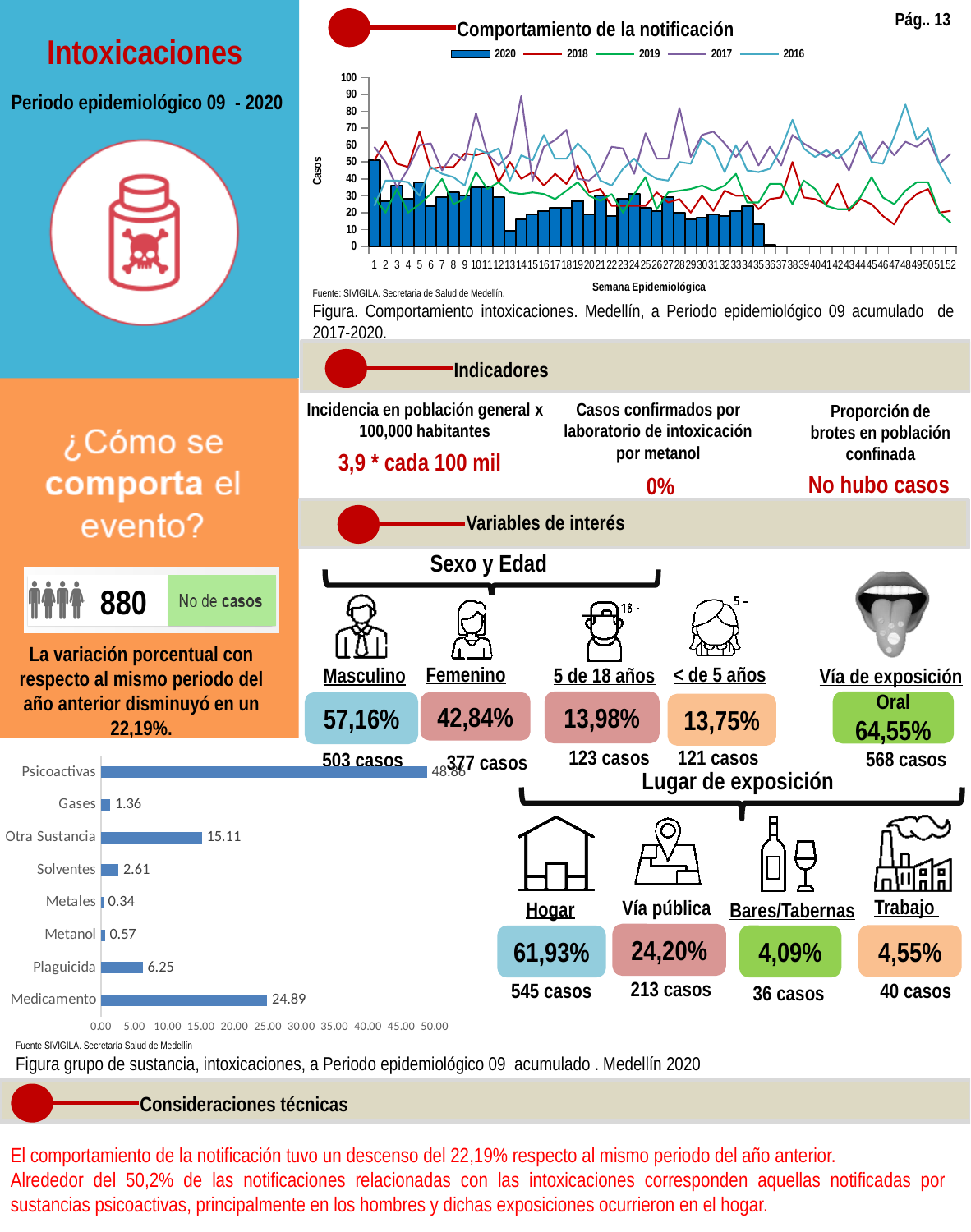
In the bar chart of substance groups (bottom left), what is the value for Plaguicida? 6.25 In the bar chart of substance groups (bottom left), what is the value for Otra Sustancia? 15.11 In the chart titled 'Comportamiento de la notificación', is the value of the 2020 bar at week 13 greater or less than 20? less In the bar chart of substance groups (bottom left), how many categories are shown? 8 In the bar chart of substance groups (bottom left), which category has the lowest value? Metales In the bar chart of substance groups (bottom left), which category has the highest value? Psicoactivas In the chart titled 'Comportamiento de la notificación', how many series does the legend list? 5 In the bar chart of substance groups (bottom left), which is larger, the value for Solventes or the value for Gases? Solventes In the bar chart of substance groups (bottom left), what is the difference between the values for Medicamento and Otra Sustancia? 9.78 In the chart titled 'Comportamiento de la notificación', what is the label of the x axis? Semana Epidemiológica What kind of chart is the chart of substance groups at the bottom left of the slide? Bar chart In the bar chart of substance groups (bottom left), what is the value for Medicamento? 24.89